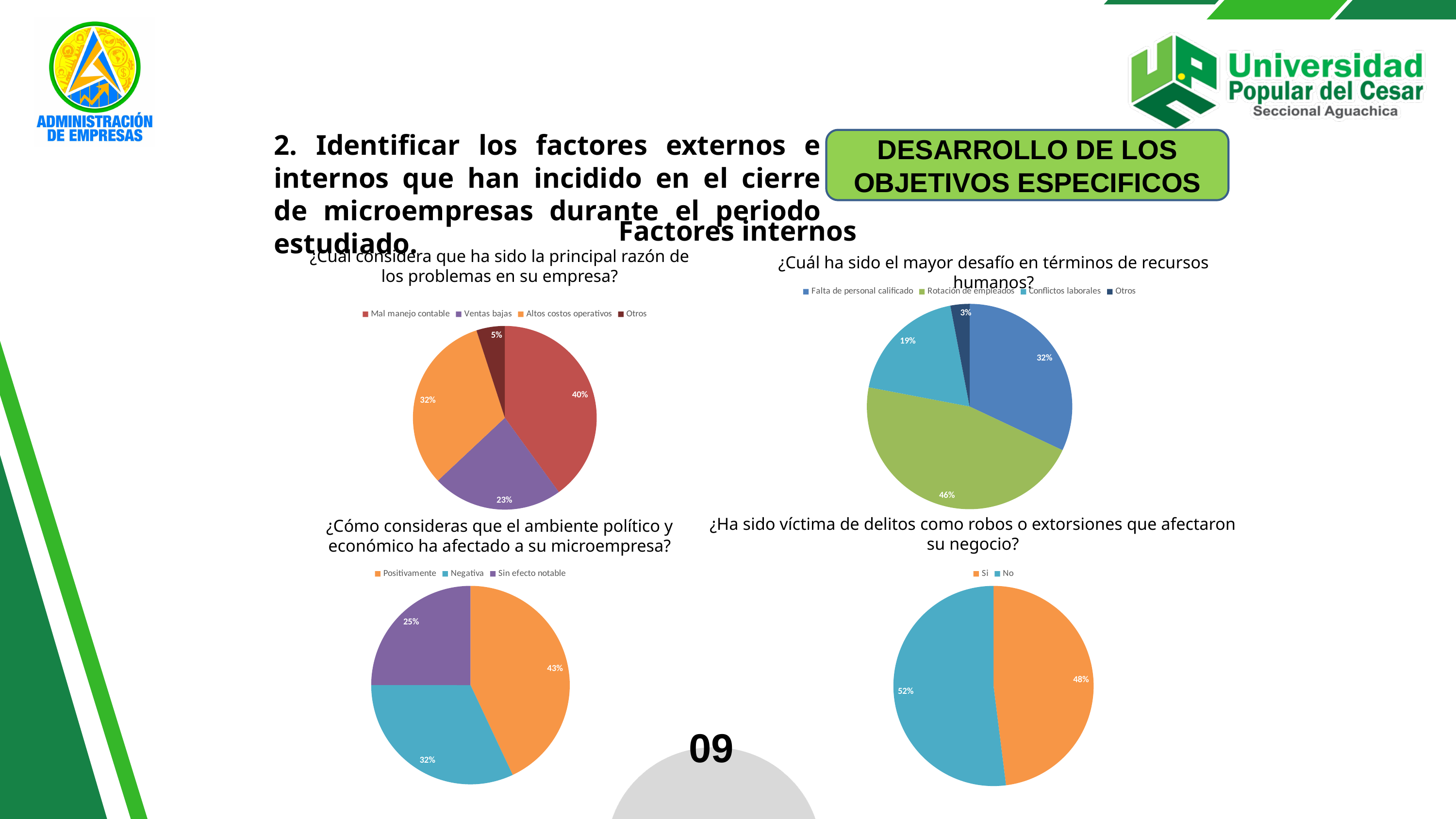
In the bottom-left pie chart (ambiente político y económico), which is larger, Positivamente or Negativa? Positivamente In the bottom-left pie chart (ambiente político y económico), what share is labelled for Sin efecto notable? 25% In the bottom-right pie chart (víctima de delitos como robos o extorsiones), how many categories are shown? 2 In the bottom-right pie chart (víctima de delitos como robos o extorsiones), what share is labelled for No? 52% In the top-right pie chart (mayor desafío en términos de recursos humanos), which category has the largest slice? Rotación de empleados In the top-left pie chart (principal razón de los problemas en su empresa), what share is labelled for Mal manejo contable? 40% In the top-left pie chart (principal razón de los problemas en su empresa), what is the difference between the Altos costos operativos and Ventas bajas shares? 9% In the top-right pie chart (mayor desafío en términos de recursos humanos), how many categories does the legend list? 4 In the bottom-left pie chart (ambiente político y económico), what colour is the Negativa slice? Teal (light blue) In the top-left pie chart (principal razón de los problemas en su empresa), which category has the smallest slice? Otros What type of chart is used for the four charts on this slide? Pie chart In the top-right pie chart (mayor desafío en términos de recursos humanos), what share is labelled for Conflictos laborales? 19%